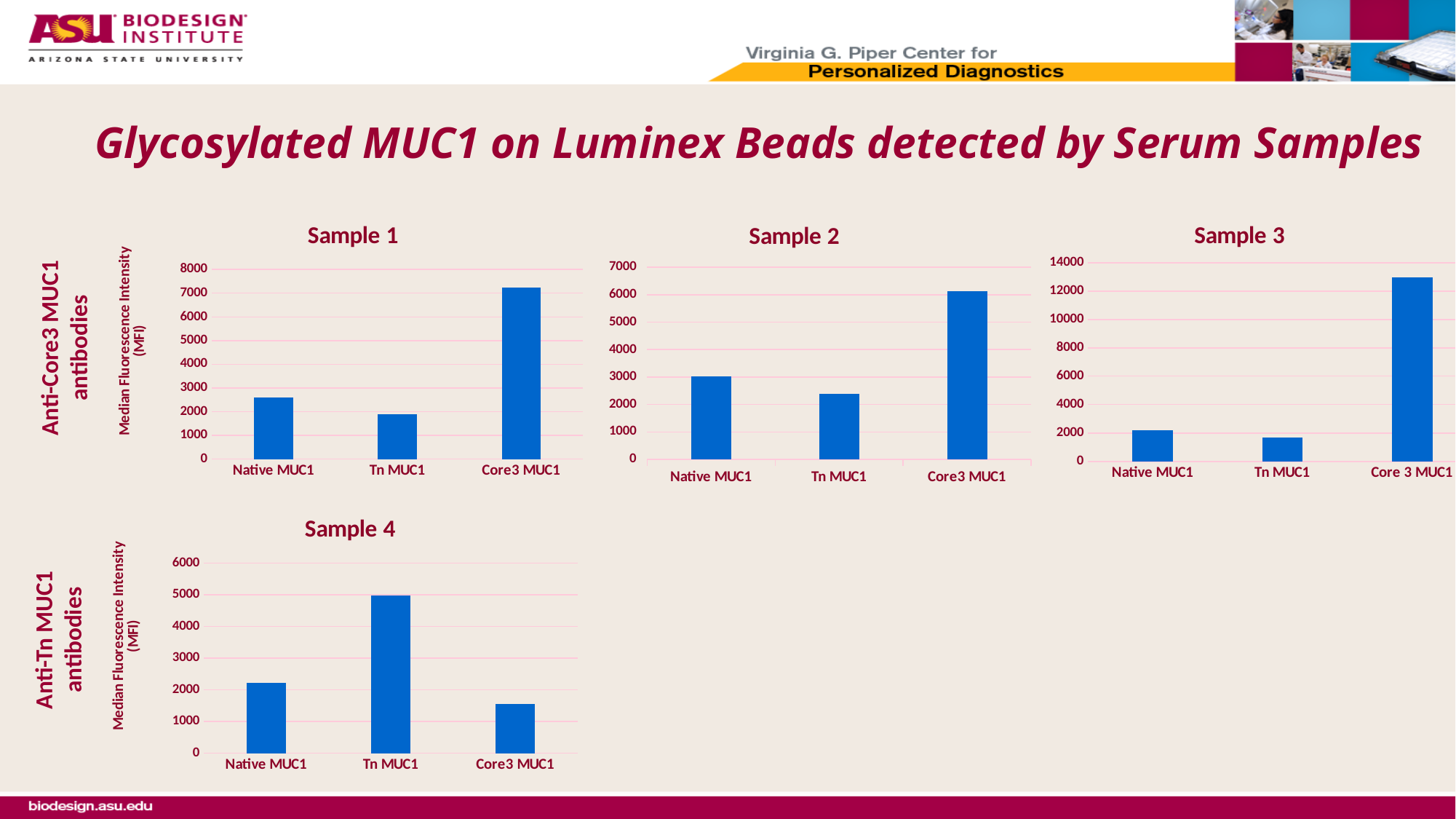
In the Sample 3 chart, which category has the lowest value? Tn MUC1 In the Sample 1 chart, which category has the lowest value? Tn MUC1 In the Sample 2 chart, is the value for Tn MUC1 greater or less than 3000? less In the Sample 1 chart, which category has the highest value? Core3 MUC1 In the Sample 4 chart, which category has the highest value? Tn MUC1 How many categories are shown in the Sample 4 chart? 3 What is the y-axis label of the Sample 1 chart? Median Fluorescence Intensity (MFI) In the Sample 4 chart, is the value for Core3 MUC1 greater or less than 2000? less In the Sample 2 chart, which is larger, Native MUC1 or Tn MUC1? Native MUC1 In the Sample 1 chart, is the value for Core3 MUC1 greater or less than 7000? greater What kind of chart is the Sample 2 chart? bar chart